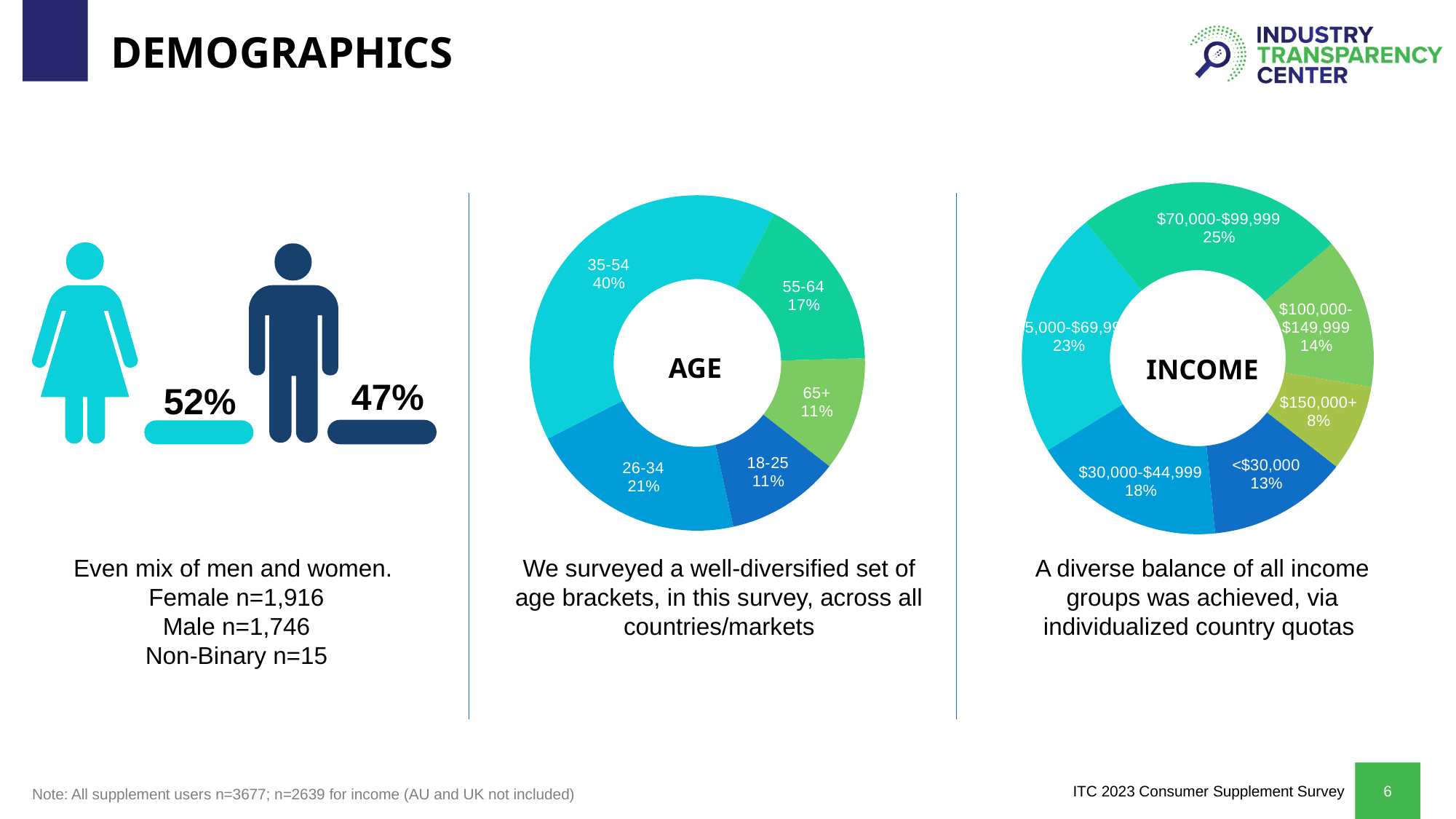
In the INCOME chart, which income group has the smallest share? $150,000+ How many age brackets are shown in the AGE chart? 5 In the INCOME chart, what percentage of respondents earn less than $30,000? 13% In the AGE chart, what share of respondents are aged 35-54? 40% In the INCOME chart, what share of respondents earn $70,000-$99,999? 25% In the AGE chart, what percentage of respondents are aged 26-34? 21% What kind of chart is the AGE chart? Pie (donut) chart How many income groups are shown in the INCOME chart? 6 In the INCOME chart, which is larger: the $30,000-$44,999 share or the $100,000-$149,999 share? $30,000-$44,999 In the INCOME chart, what is the difference in percentage points between the $70,000-$99,999 share and the $150,000+ share? 17 percentage points In the AGE chart, which age bracket has the largest share? 35-54 In the AGE chart, how many percentage points larger is the 26-34 share than the 55-64 share? 4 percentage points